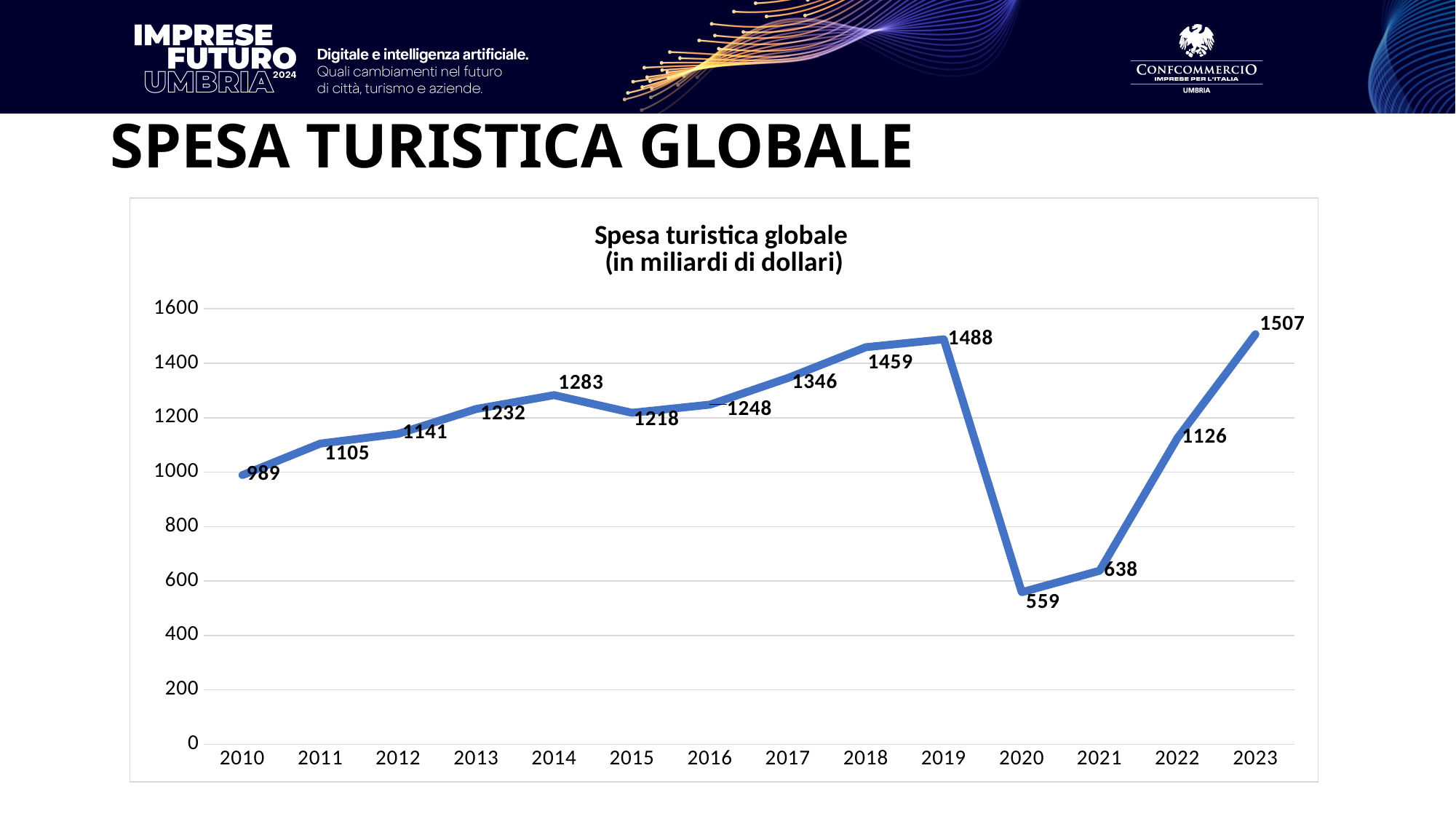
Do the values rise or fall from 2010 to 2014? rise Is the value for 2021 greater or less than 800? less What is the value for 2010? 989 What kind of chart is shown? line chart Which year has the lowest value? 2020 What is the difference between the values for 2019 and 2020? 929 Which year has the highest value? 2023 How many years are plotted on the x axis? 14 Which is larger, the value for 2014 or the value for 2015? 2014 What is the value for 2020? 559 What is the value for 2019? 1488 What is the difference between the values for 2023 and 2022? 381